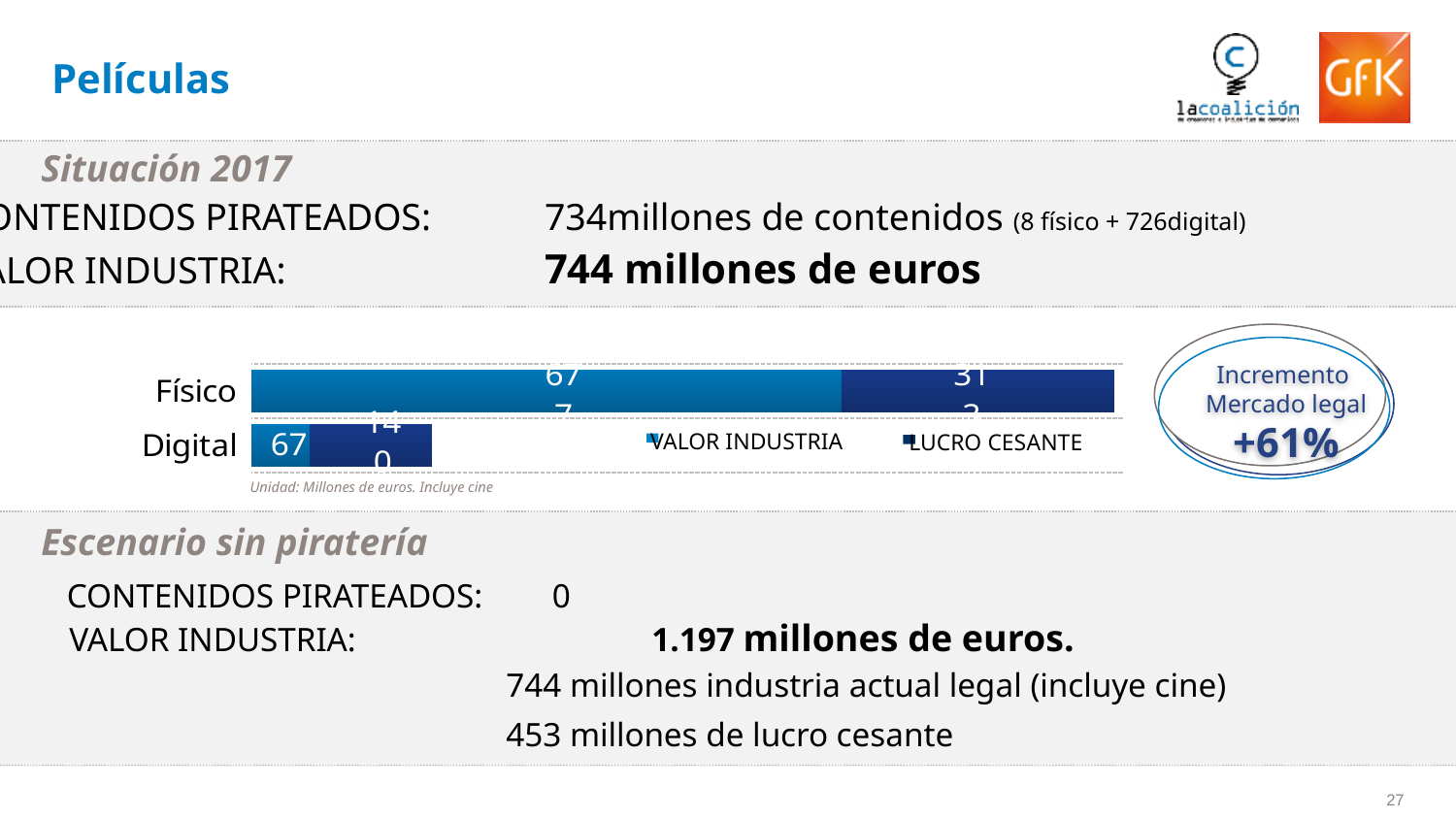
Which category has the longer total bar, Físico or Digital? Físico What kind of chart is shown on the slide? Stacked bar chart What unit does the note under the chart say the values are in? Millones de euros Within the Físico bar, which segment is larger, VALOR INDUSTRIA or LUCRO CESANTE? VALOR INDUSTRIA What is the VALOR INDUSTRIA value for Digital? 67 How many series does the chart legend list? 2 Which category is listed first (at the top) of the bar chart? Físico Is the VALOR INDUSTRIA segment larger for Físico or for Digital? Físico How many categories does the bar chart show? 2 Which category has the shorter total bar? Digital Within the Digital bar, which segment is larger, VALOR INDUSTRIA or LUCRO CESANTE? LUCRO CESANTE What are the two series named in the chart legend? VALOR INDUSTRIA and LUCRO CESANTE